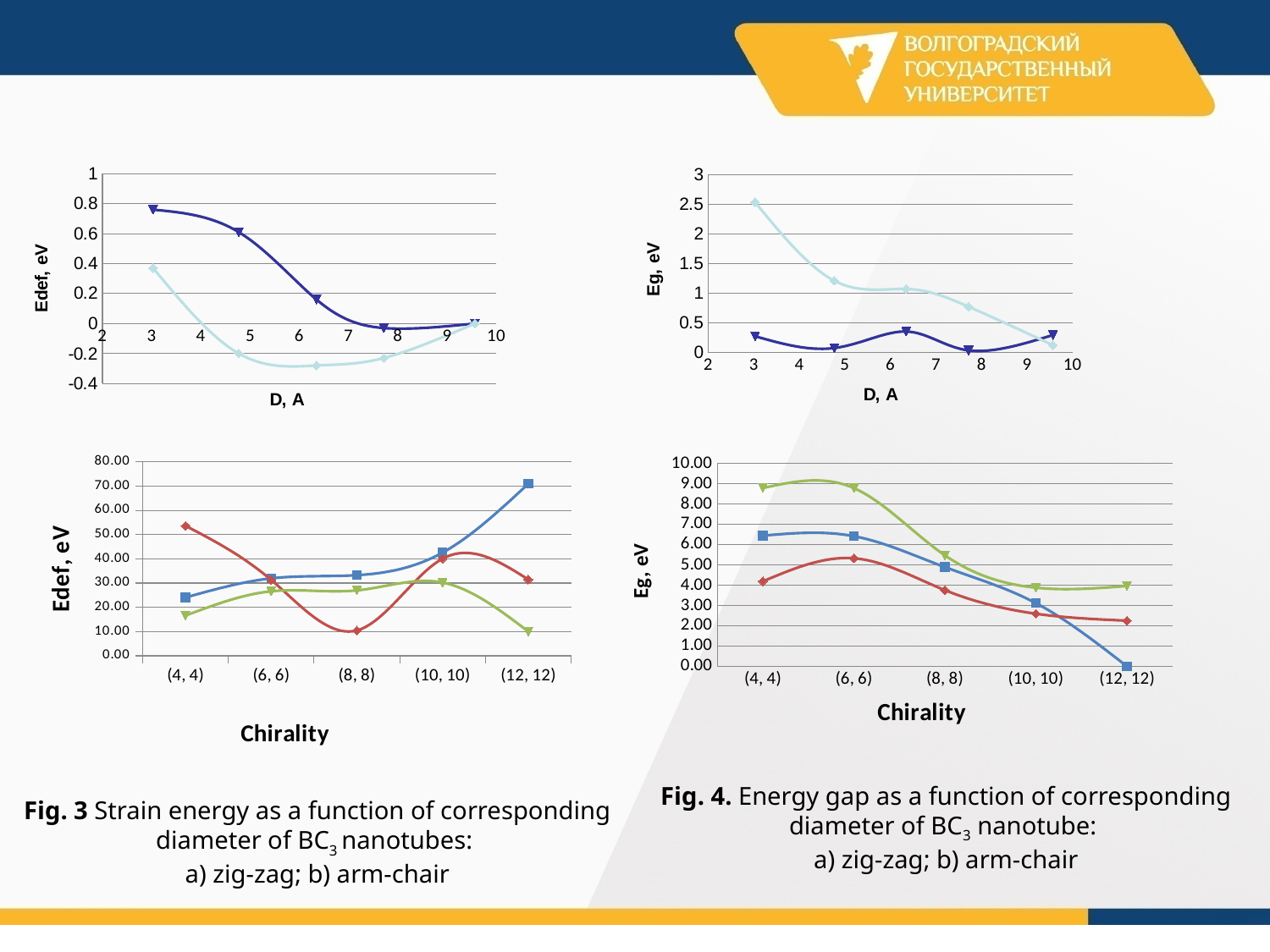
How many chirality categories are shown on the x axis of the bottom-right chart (Eg vs Chirality)? 5 In the top-right chart (Eg vs D, A), is the value of the light blue series at D = 3 greater or less than 2? greater In the bottom-right chart (Eg vs Chirality), is the value of the blue series at (12, 12) greater or less than 1.00? less In the bottom-left chart (Edef vs Chirality), is the value of the blue series at (12, 12) greater or less than 60.00? greater What kind of chart is the bottom-left chart (Edef vs Chirality)? line chart In the top-right chart (Eg vs D, A), does the light blue series generally rise or fall as D increases? fall In the bottom-right chart (Eg vs Chirality), at which chirality is the blue series lowest? (12, 12) What is the x-axis label of the bottom-left chart? Chirality In the bottom-left chart (Edef vs Chirality), at which chirality is the blue series highest? (12, 12)